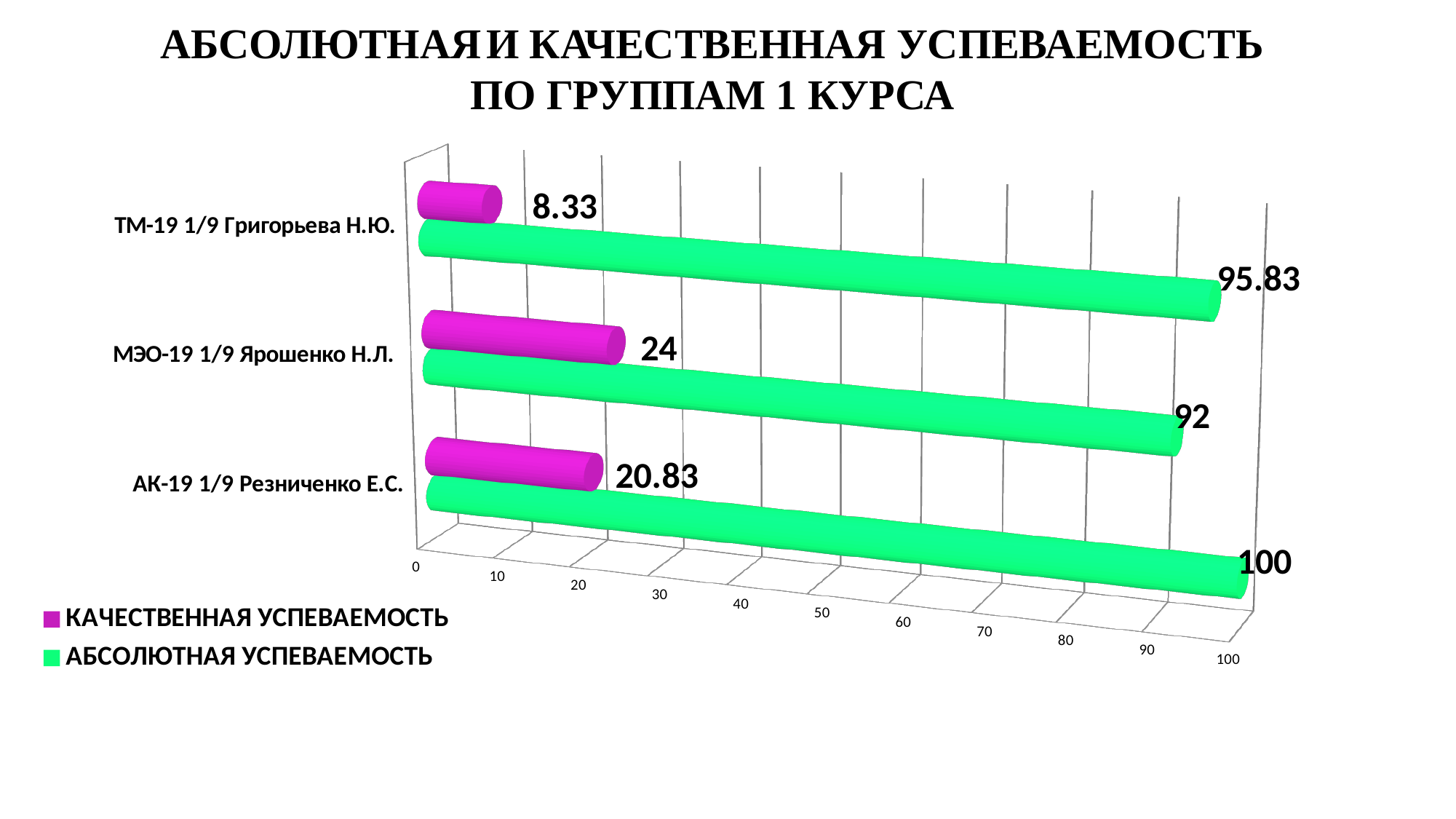
What is the АБСОЛЮТНАЯ УСПЕВАЕМОСТЬ value for МЭО-19 1/9 Ярошенко Н.Л.? 92 How many series does the legend list? 2 What is the difference between the АБСОЛЮТНАЯ УСПЕВАЕМОСТЬ values for АК-19 1/9 Резниченко Е.С. and МЭО-19 1/9 Ярошенко Н.Л.? 8 Which group has the highest АБСОЛЮТНАЯ УСПЕВАЕМОСТЬ? АК-19 1/9 Резниченко Е.С. Which group has the lowest КАЧЕСТВЕННАЯ УСПЕВАЕМОСТЬ? ТМ-19 1/9 Григорьева Н.Ю. What kind of chart is shown on the slide? bar chart Is the АБСОЛЮТНАЯ УСПЕВАЕМОСТЬ value for ТМ-19 1/9 Григорьева Н.Ю. greater or less than 90? greater Which group has a higher КАЧЕСТВЕННАЯ УСПЕВАЕМОСТЬ, МЭО-19 1/9 Ярошенко Н.Л. or АК-19 1/9 Резниченко Е.С.? МЭО-19 1/9 Ярошенко Н.Л. What is the КАЧЕСТВЕННАЯ УСПЕВАЕМОСТЬ value for ТМ-19 1/9 Григорьева Н.Ю.? 8.33 What is the КАЧЕСТВЕННАЯ УСПЕВАЕМОСТЬ value for АК-19 1/9 Резниченко Е.С.? 20.83 How many groups are shown on the chart? 3 What colour are the bars for АБСОЛЮТНАЯ УСПЕВАЕМОСТЬ? green